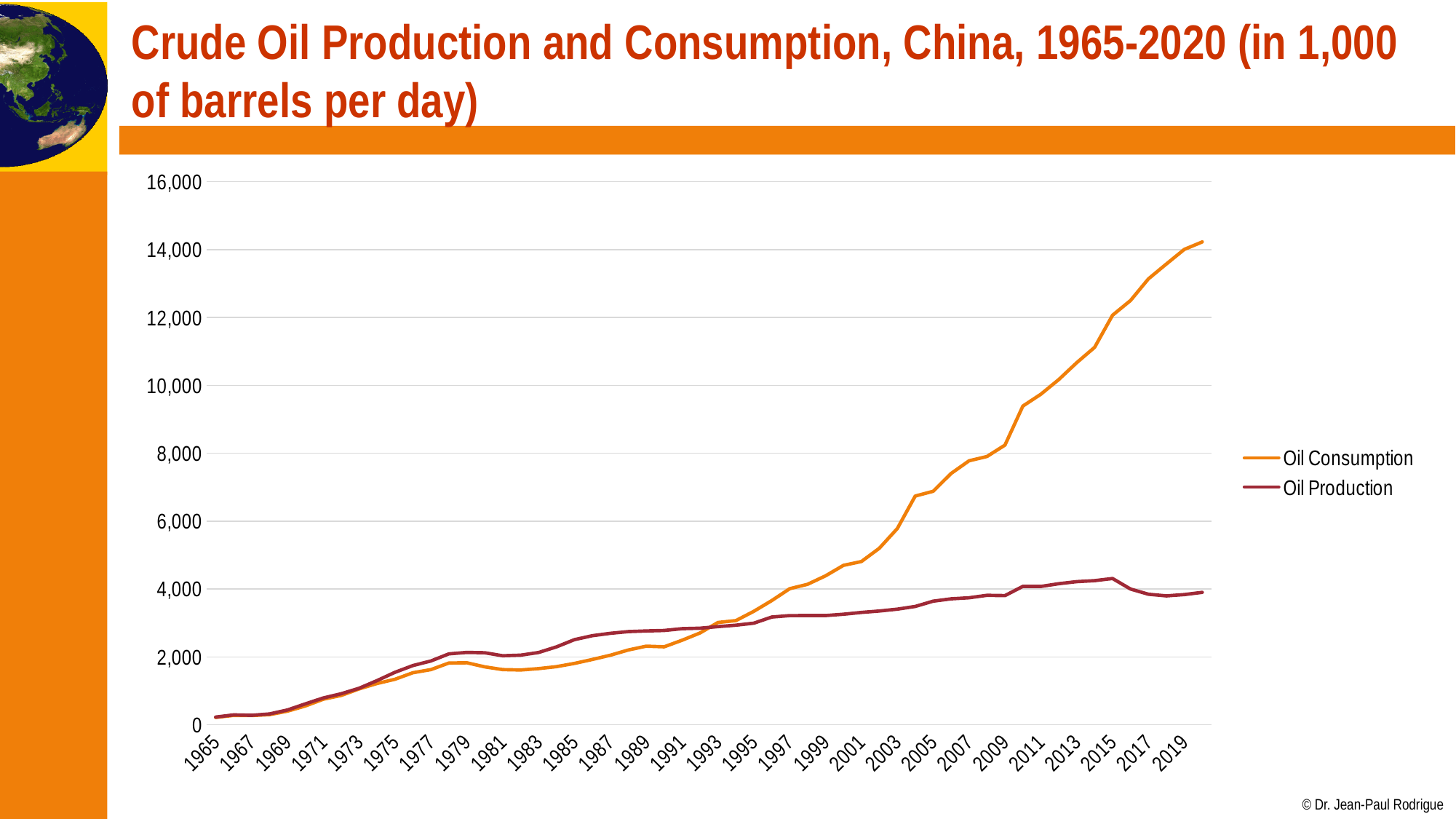
Is the value for Oil Consumption in 1981 greater or less than 2,000? less What colour is the Oil Production line? Dark red In 2019, which is larger, Oil Consumption or Oil Production? Oil Consumption Does Oil Consumption generally rise or fall from 1965 to 2020? Rise Is the value for Oil Consumption in 2017 greater or less than 12,000? greater Which two series are listed in the legend? Oil Consumption and Oil Production What kind of chart is shown on the slide? Line chart Is the value for Oil Production in 2019 greater or less than 6,000? less How many series does the legend list? 2 In 1985, which is larger, Oil Consumption or Oil Production? Oil Production